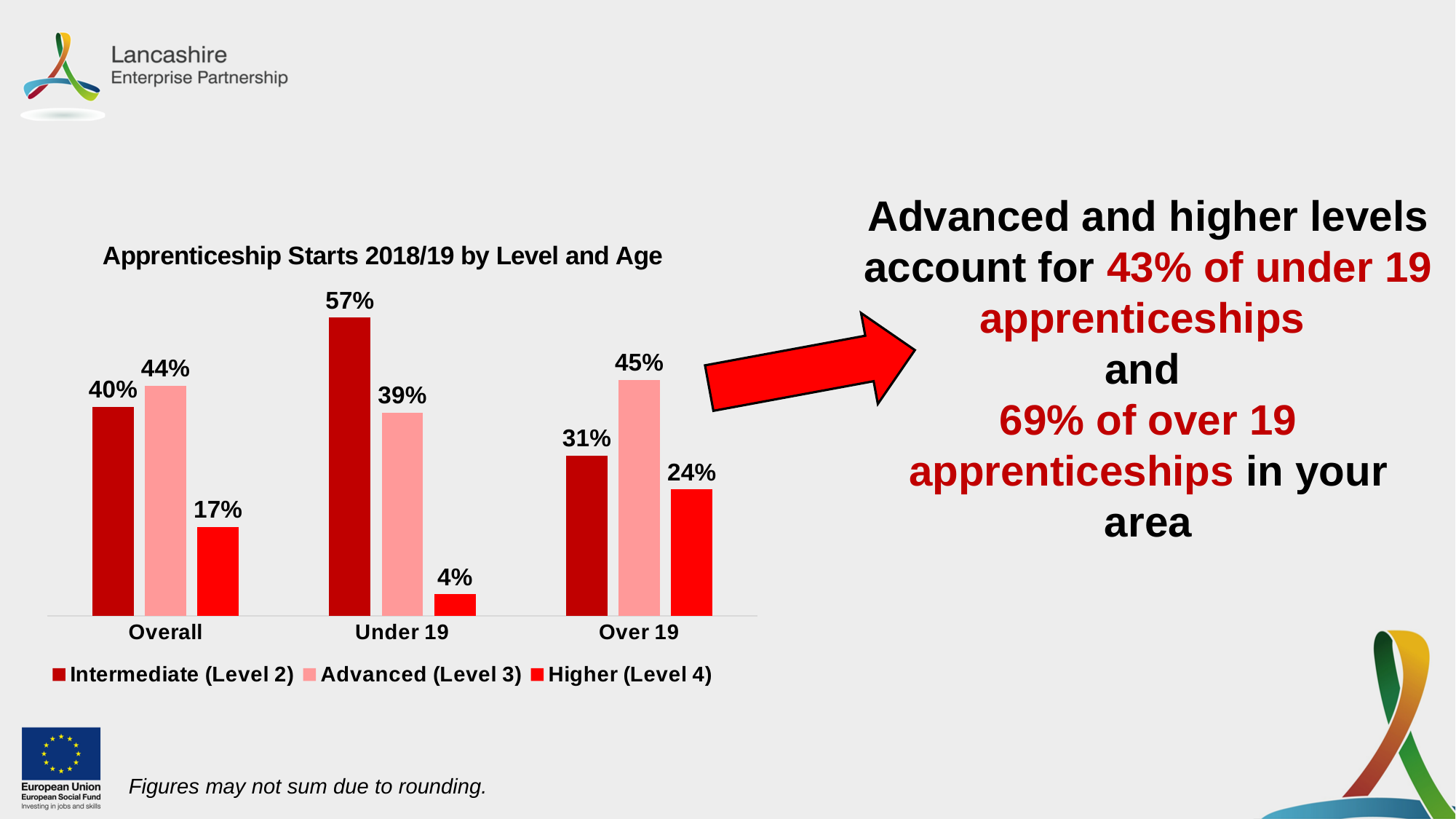
Which category has the lowest value for Higher (Level 4)? Under 19 What is the title of the chart? Apprenticeship Starts 2018/19 by Level and Age What kind of chart is shown on the slide? Bar chart What is the value for Advanced (Level 3) in the Overall category? 44% Which is larger in the Over 19 category: Intermediate (Level 2) or Advanced (Level 3)? Advanced (Level 3) Which category has the highest value for Intermediate (Level 2)? Under 19 What is the difference between the Advanced (Level 3) values for Over 19 and Under 19? 6% What is the value for Intermediate (Level 2) in the Under 19 category? 57% How many series does the legend list? 3 What is the value for Higher (Level 4) in the Over 19 category? 24% How many categories are shown on the x axis? 3 Which series is shown in the lightest pink colour? Advanced (Level 3)